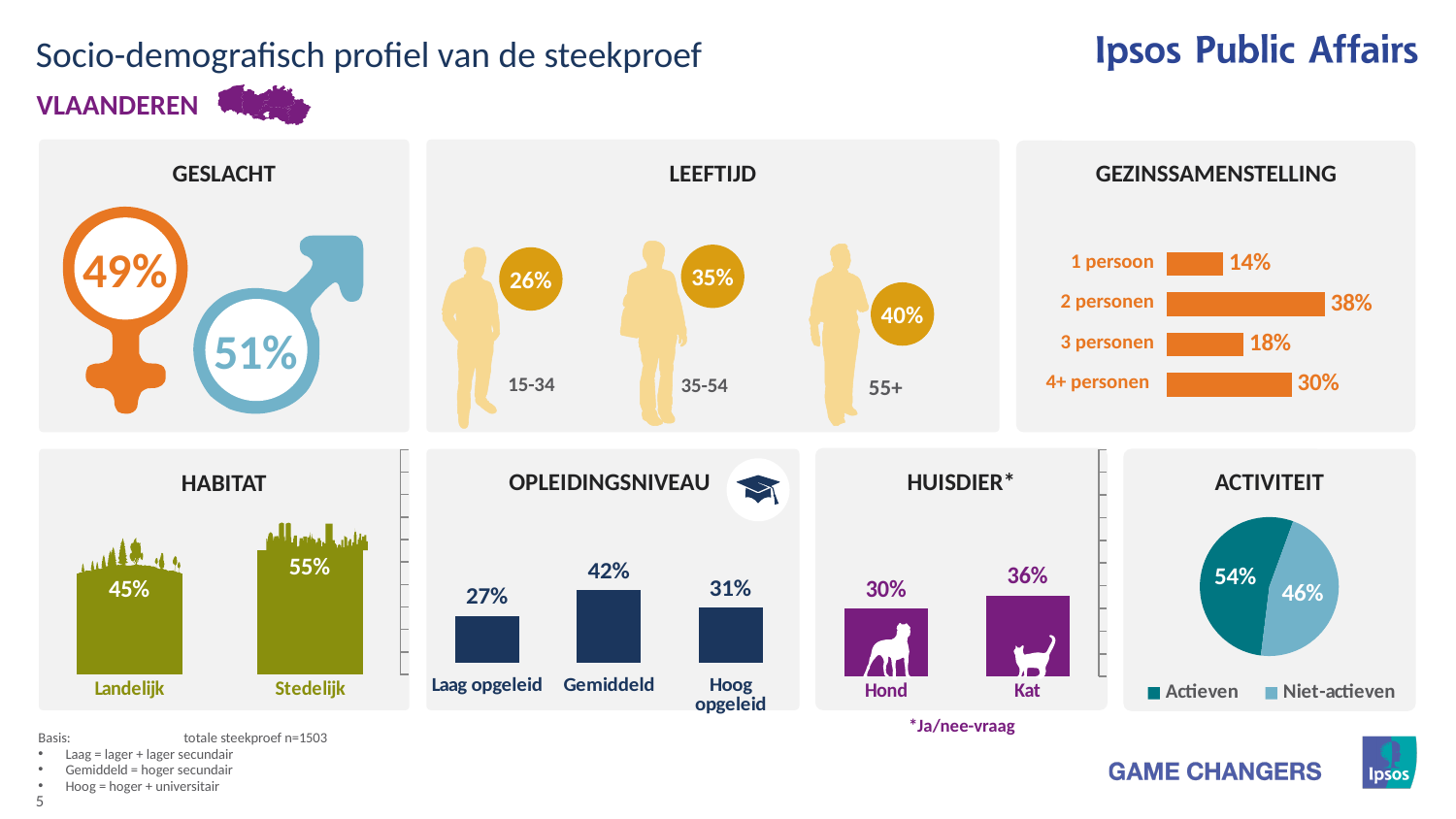
In the GEZINSSAMENSTELLING chart, which category has the lowest value? 1 persoon In the ACTIVITEIT chart, what share of the pie is Actieven? 54% In the GEZINSSAMENSTELLING chart, what is the difference between 4+ personen and 3 personen? 12% How many categories does the GEZINSSAMENSTELLING chart show? 4 In the OPLEIDINGSNIVEAU chart, which category has the highest value? Gemiddeld In the HABITAT chart, what is the value for Stedelijk? 55% How many entries does the legend of the ACTIVITEIT chart list? 2 In the HABITAT chart, which is larger, Landelijk or Stedelijk? Stedelijk In the HUISDIER chart, what is the difference between Kat and Hond? 6% In the OPLEIDINGSNIVEAU chart, what is the value for Laag opgeleid? 27% What kind of chart is the HUISDIER chart? bar chart In the GEZINSSAMENSTELLING chart, what is the value for 2 personen? 38%